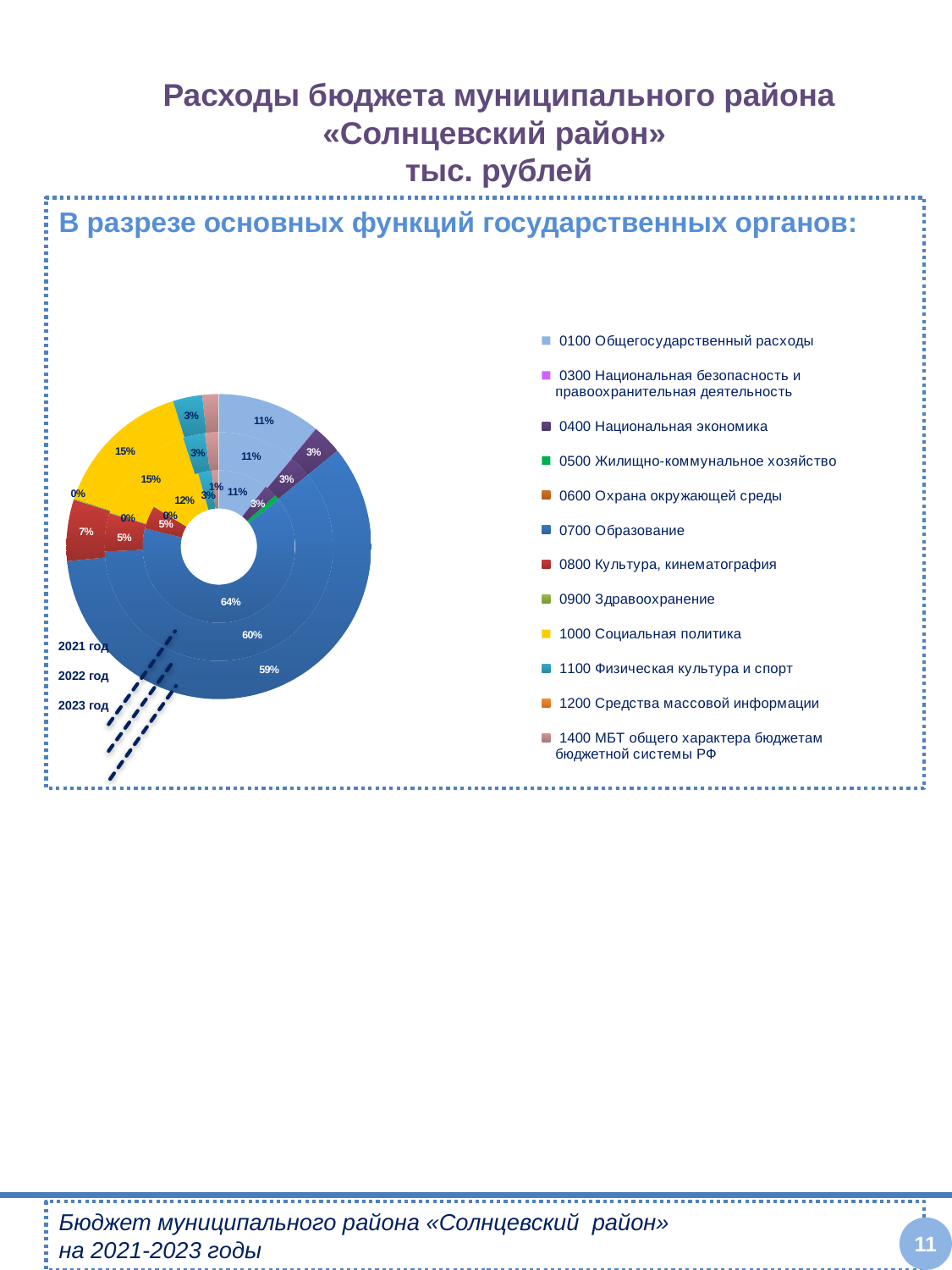
By how many percentage points does the share of 0700 Образование differ between the innermost ring (64%) and the outermost ring (59%)? 5 percentage points How many entries does the chart legend list? 12 What share does 0800 Культура, кинематография have in the outermost ring (2023 год)? 7% What share does 0700 Образование have in the innermost ring (2021 год)? 64% In the outermost ring, which is larger: the share of 1000 Социальная политика or 0800 Культура, кинематография? 1000 Социальная политика What share does 1000 Социальная политика have in the outermost ring (2023 год)? 15% How many rings (years) does the doughnut chart have? 3 What share does 0700 Образование have in the outermost ring (2023 год)? 59% Which category has the largest share in every ring of the chart? 0700 Образование What share does 0700 Образование have in the middle ring (2022 год)? 60% What kind of chart is shown on the slide? Doughnut (pie) chart Does the share of 0700 Образование rise or fall from the innermost ring (2021 год) to the outermost ring (2023 год)? Fall